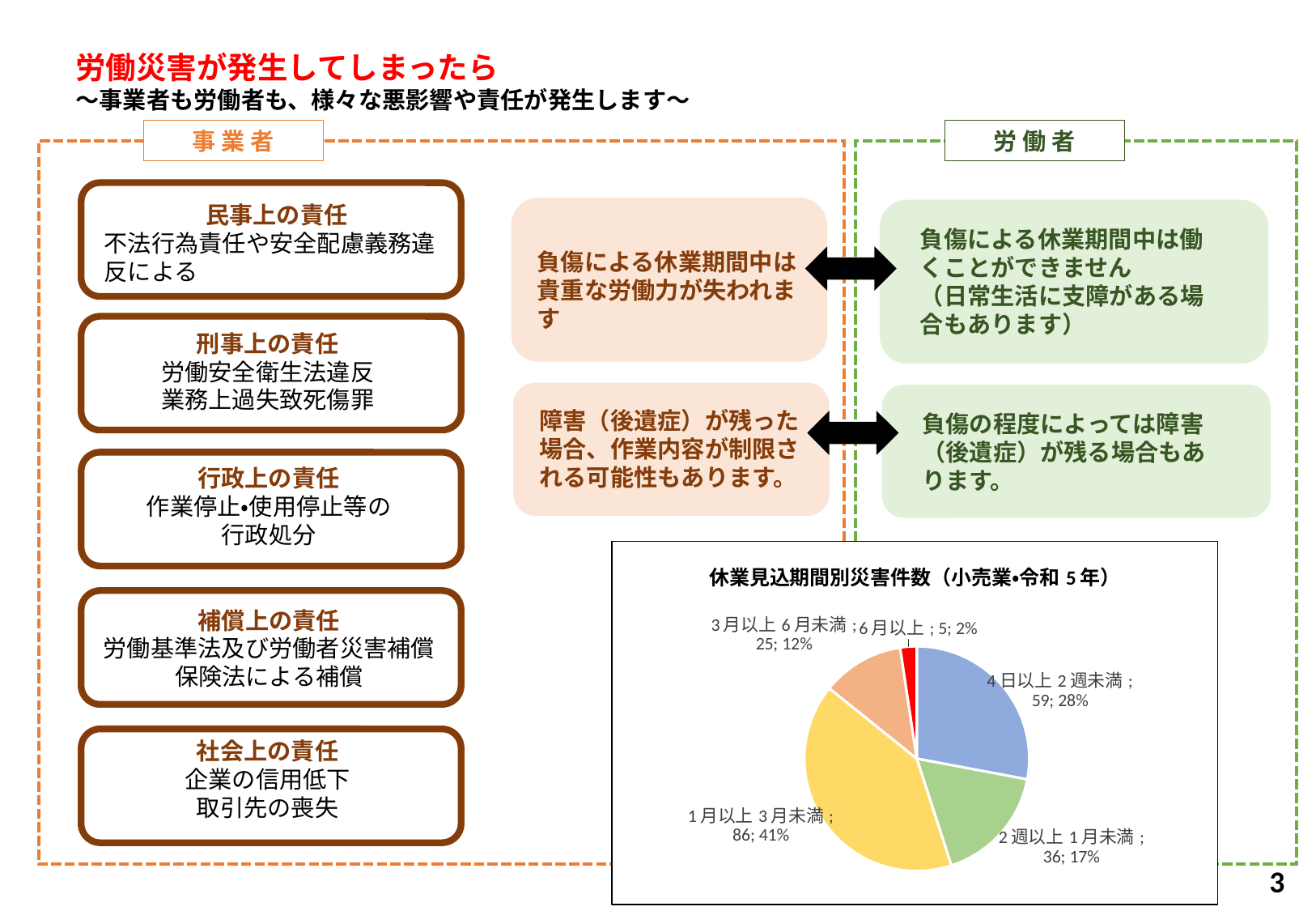
How many cases are shown for 1月以上3月未満? 86 What percentage share does 4日以上2週未満 have in the pie chart? 28% What is the title of the pie chart? 休業見込期間別災害件数（小売業・令和５年） How many cases are shown for 6月以上? 5 Which has more cases, 3月以上6月未満 or 2週以上1月未満? 2週以上1月未満 Which category has the largest slice in the pie chart? 1月以上3月未満 What percentage share does 3月以上6月未満 have in the pie chart? 12% Which category has the smallest slice in the pie chart? 6月以上 How many slices does the pie chart have? 5 What kind of chart is shown on the slide? pie chart What is the difference in cases between 4日以上2週未満 and 2週以上1月未満? 23 What is the total number of cases across all slices of the pie chart? 211